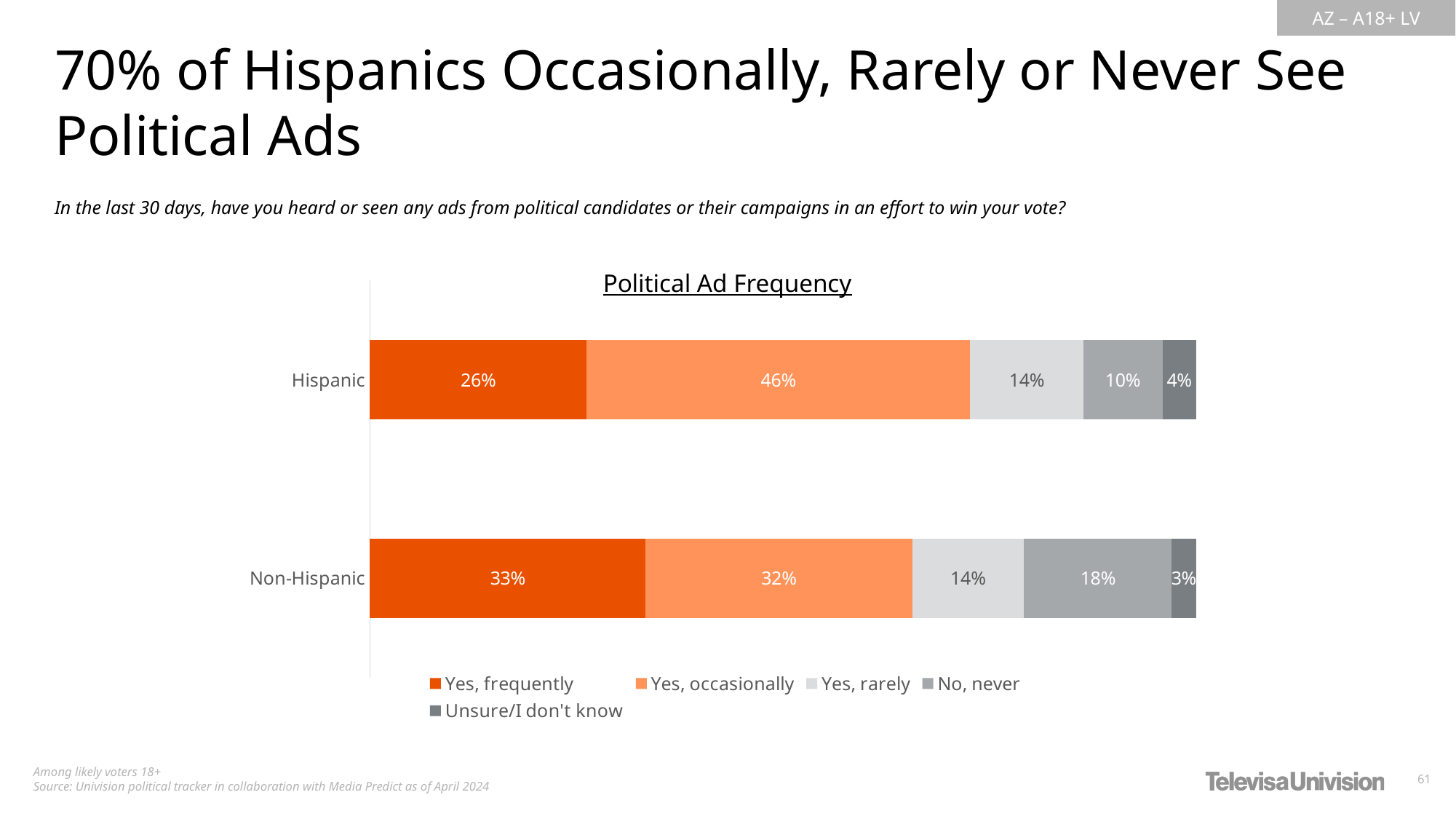
What percentage of Hispanic respondents said they see political ads 'Yes, frequently'? 26% How many series does the legend list? 5 What is the difference between the 'Yes, occasionally' values for Hispanic and Non-Hispanic respondents? 14 percentage points How many groups (bars) are shown in the chart? 2 What is the 'No, never' value for Non-Hispanic respondents? 18% What is the 'Unsure/I don't know' value for Hispanic respondents? 4% What type of chart is shown on the slide? Stacked bar chart Which group has a larger 'No, never' share, Hispanic or Non-Hispanic? Non-Hispanic What percentage of Non-Hispanic respondents answered 'Yes, occasionally'? 32% Which response category has the lowest value for Non-Hispanic respondents? Unsure/I don't know Which response category has the highest value for Hispanic respondents? Yes, occasionally What is the title of the chart? Political Ad Frequency